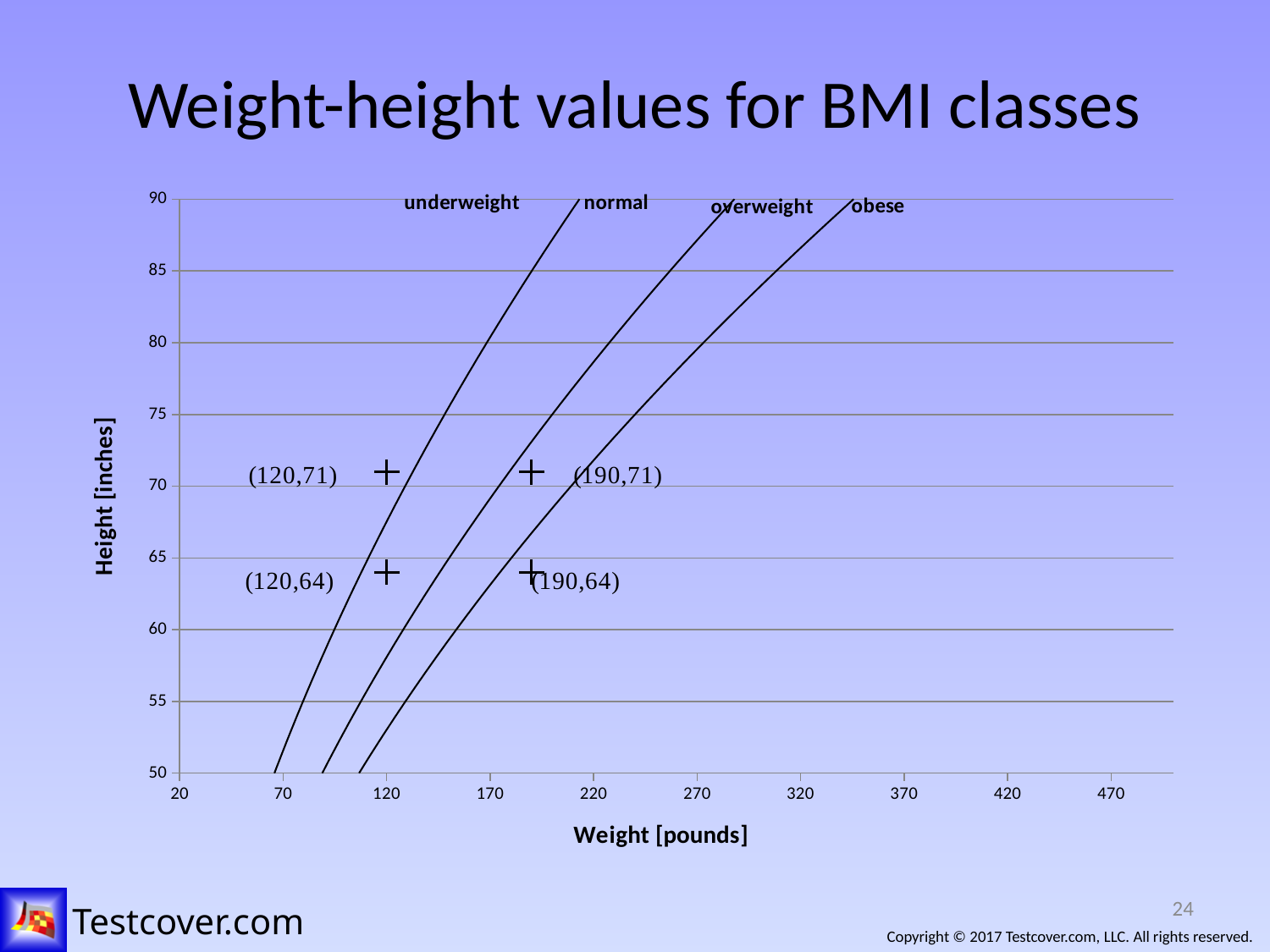
Which BMI class region does the point (190,64) fall in? obese Which BMI class region does the point (120,71) fall in? underweight Do the curves rise or fall as weight increases along the x axis? rise What is the label of the x axis? Weight [pounds] What kind of chart is shown on the slide? line chart How many curves separating the BMI classes are drawn on the chart? 3 What are the coordinates of the marked point in the lower right of the chart? (190,64) Which BMI class region does the point (120,64) fall in? normal How many marked points (crosses) are labeled with coordinates on the chart? 4 What is the title of the chart? Weight-height values for BMI classes What are the coordinates of the marked point in the upper left of the chart? (120,71)